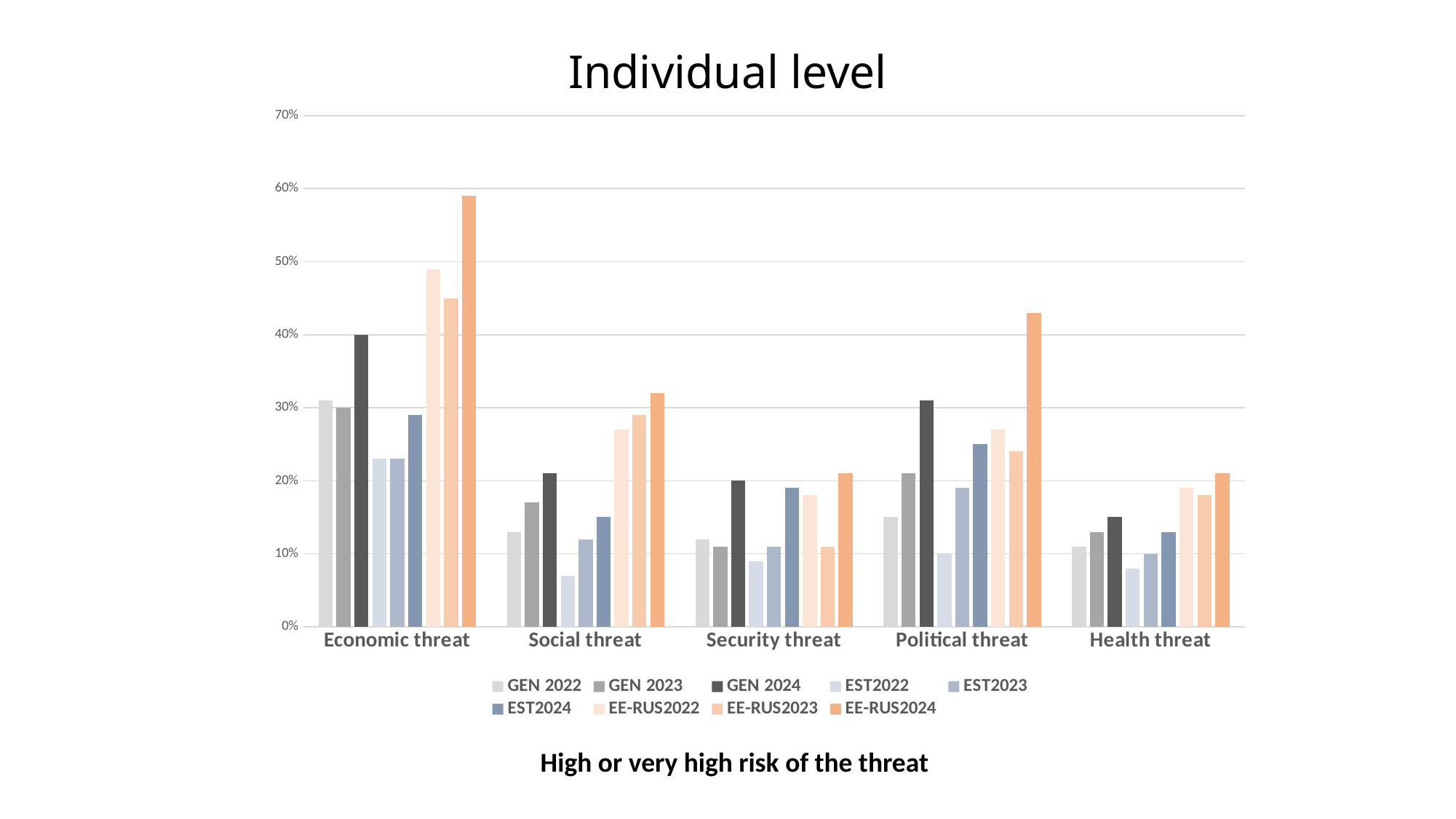
How many series does the legend list? 9 What is the title of the chart? Individual level In which category is the EE-RUS2024 bar the highest? Economic threat How many threat categories are shown on the x axis? 5 In Economic threat, which is larger: EE-RUS2022 or EE-RUS2023? EE-RUS2022 Is the value for EE-RUS2024 in Political threat greater or less than 40%? greater In Political threat, which is larger: GEN 2024 or EST2024? GEN 2024 What kind of chart is shown on the slide? bar chart Is the value for EST2022 in Social threat greater or less than 10%? less In which category is the GEN 2024 bar the lowest? Health threat What caption appears below the legend? High or very high risk of the threat Is the value for EE-RUS2024 in Economic threat greater or less than 50%? greater